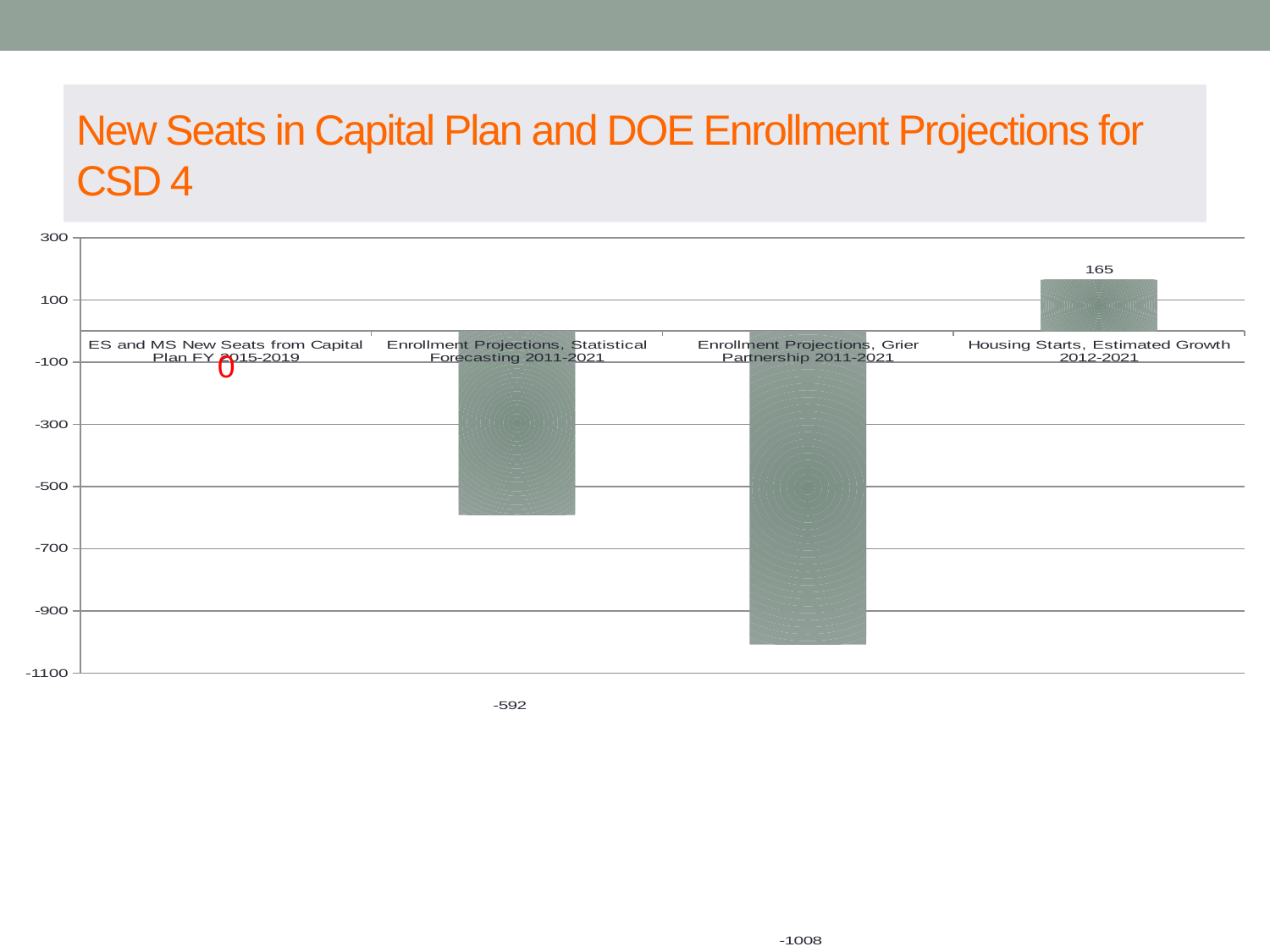
What is the difference between the Statistical Forecasting projection (-592) and the Grier Partnership projection (-1008)? 416 What is the value for Enrollment Projections, Grier Partnership 2011-2021? -1008 Which is larger, the value for Housing Starts, Estimated Growth 2012-2021 or the value for Enrollment Projections, Statistical Forecasting 2011-2021? Housing Starts, Estimated Growth 2012-2021 Which category has the lowest value? Enrollment Projections, Grier Partnership 2011-2021 What is the value for Enrollment Projections, Statistical Forecasting 2011-2021? -592 How many categories are shown in the chart? 4 What is the value for Housing Starts, Estimated Growth 2012-2021? 165 Which category has the highest value? Housing Starts, Estimated Growth 2012-2021 Is the value for Enrollment Projections, Grier Partnership 2011-2021 greater or less than -900? less What is the value for ES and MS New Seats from Capital Plan FY 2015-2019? 0 What is the title of the slide containing the chart? New Seats in Capital Plan and DOE Enrollment Projections for CSD 4 What kind of chart is shown on the slide? bar chart